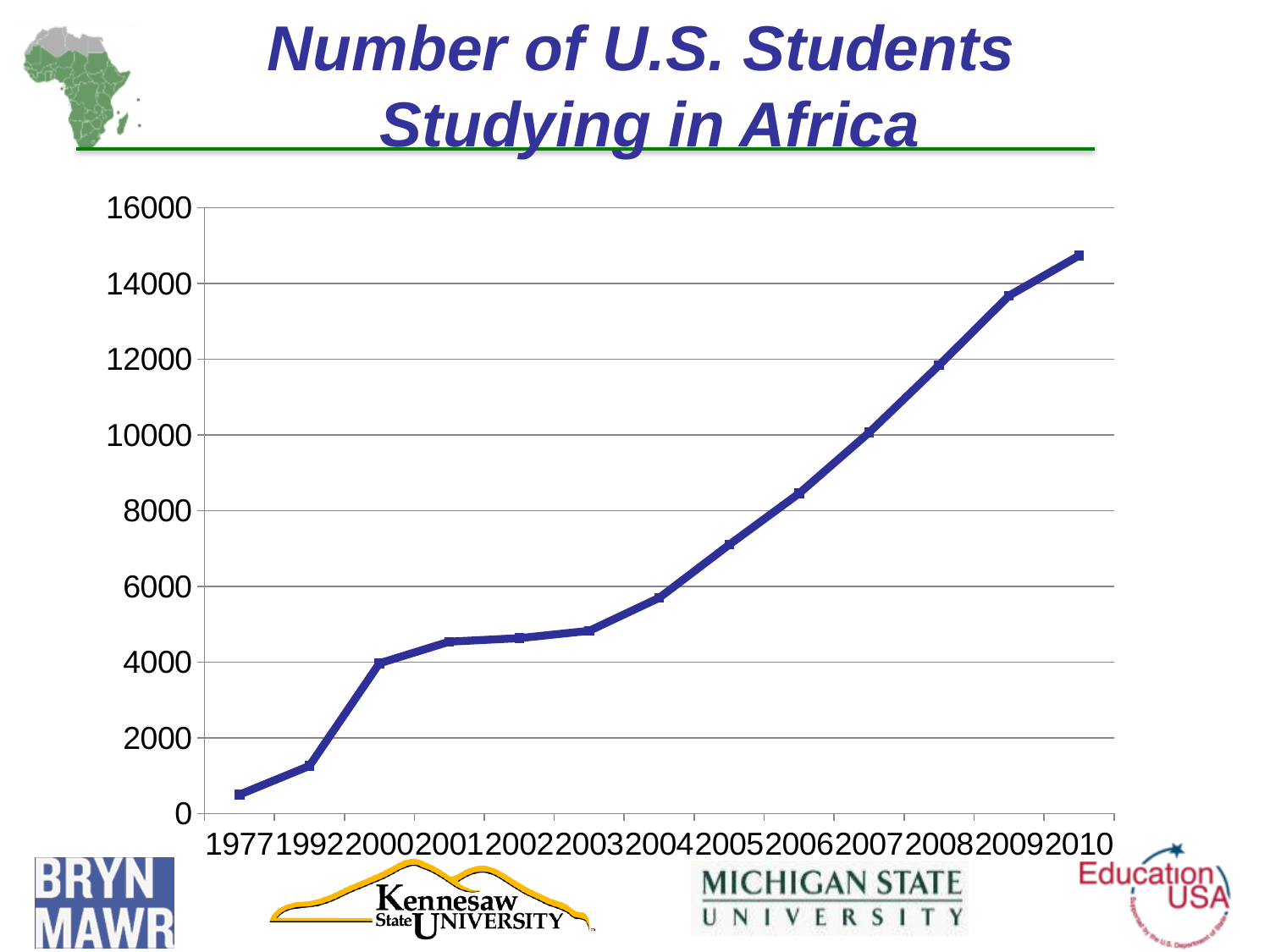
Is the value for 2010 greater or less than 14000? greater Do the values generally rise or fall from 1977 to 2010? rise Which year has the highest number of U.S. students studying in Africa? 2010 What is the title of the chart? Number of U.S. Students Studying in Africa What kind of chart is shown on the slide? line chart Which year has the lowest number of U.S. students studying in Africa? 1977 Is the value for 2001 greater or less than 4000? greater Which year has the larger value, 2000 or 2009? 2009 Is the value for 2004 greater or less than 6000? less How many years are plotted on the x axis? 13